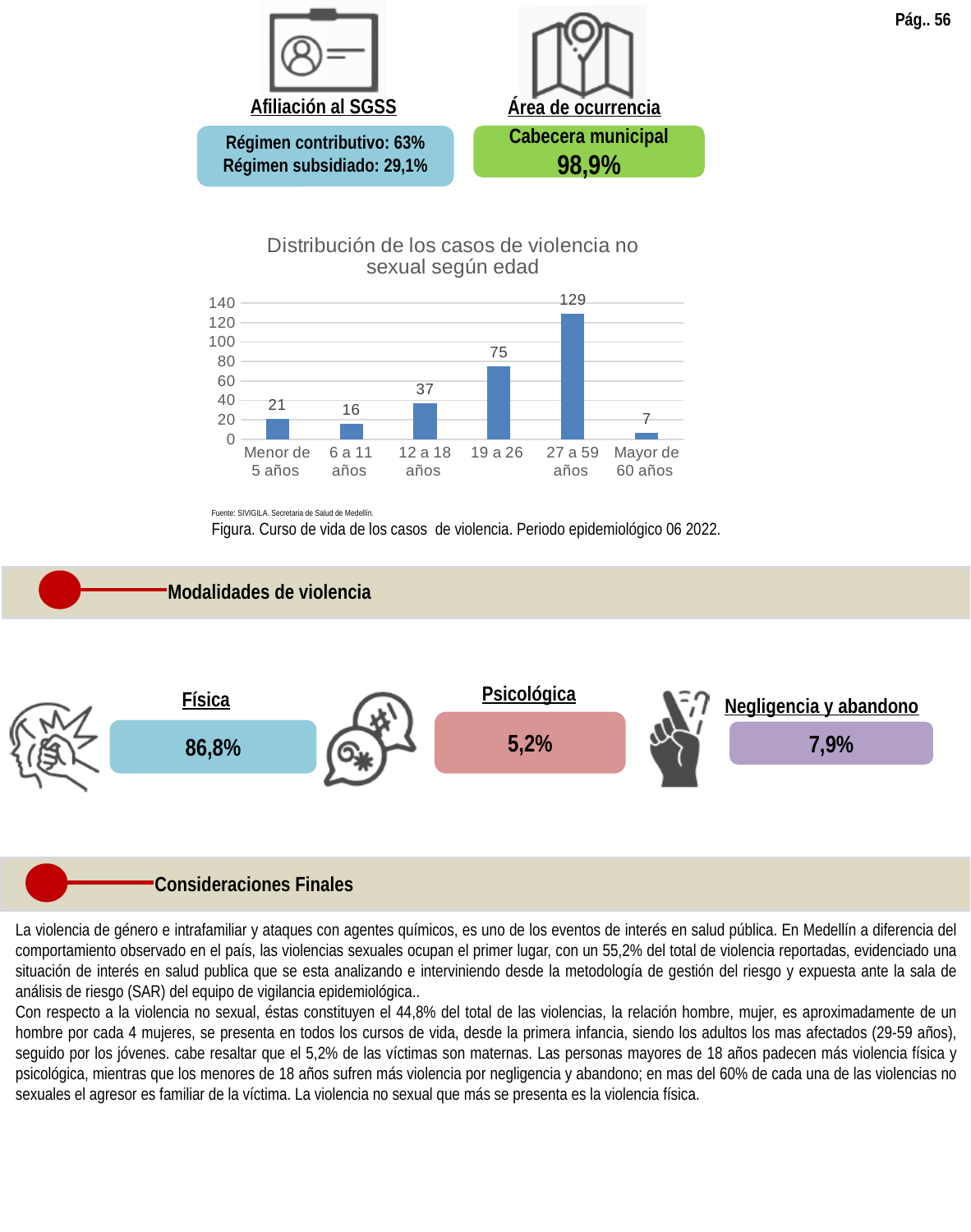
What is the difference between the values for 'Menor de 5 años' and '6 a 11 años'? 5 Which is larger: the value for '12 a 18 años' or the value for '6 a 11 años'? 12 a 18 años Which age category has the highest value in the chart? 27 a 59 años What is the difference between the values for '27 a 59 años' and '19 a 26'? 54 What is the title of the chart on the slide? Distribución de los casos de violencia no sexual según edad What kind of chart is 'Distribución de los casos de violencia no sexual según edad'? bar chart What is the value for 'Menor de 5 años' in the chart? 21 What is the value for the '27 a 59 años' category in the chart 'Distribución de los casos de violencia no sexual según edad'? 129 Which age category has the lowest value in the chart? Mayor de 60 años How many age categories are shown in the chart? 6 Is the value for '19 a 26' greater or less than 60? greater What is the value for '19 a 26' in the chart? 75